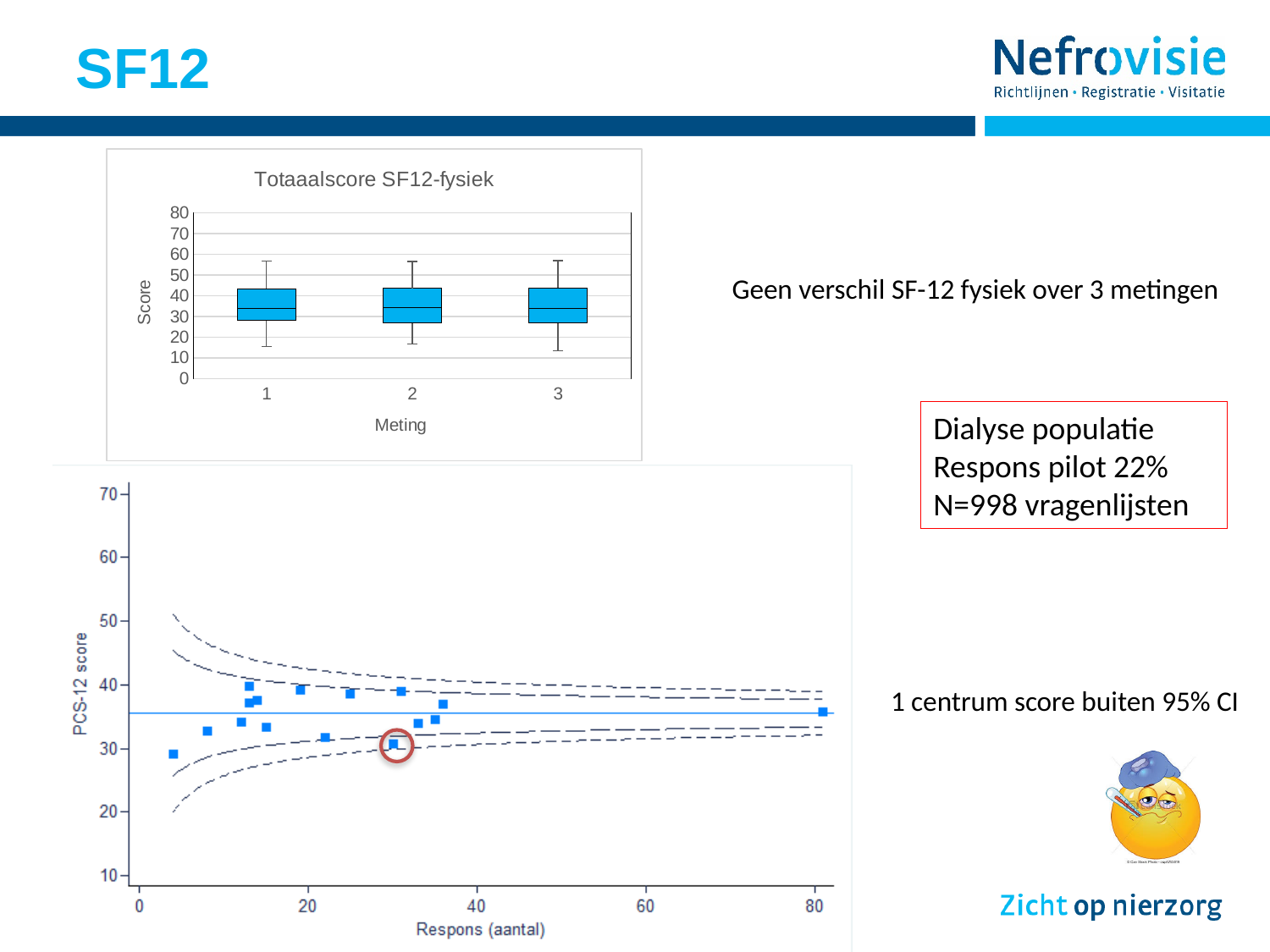
What kind of chart is the lower-left chart with 'PCS-12 score' on the y axis? scatter plot In the lower-left chart, how many points are circled in red? 1 In the lower-left chart, what is the label of the x axis? Respons (aantal) In the chart titled 'Totaaalscore SF12-fysiek', what is the highest value shown on the y axis? 80 In the chart titled 'Totaaalscore SF12-fysiek', is the top of the upper whisker for Meting 3 greater or less than 50? greater What kind of chart is the chart titled 'Totaaalscore SF12-fysiek'? box plot In the chart titled 'Totaaalscore SF12-fysiek', what is the label of the x axis? Meting In the chart titled 'Totaaalscore SF12-fysiek', is the median score for Meting 1 greater or less than 50? less In the chart titled 'Totaaalscore SF12-fysiek', how many boxes (Meting categories) are plotted? 3 In the lower-left chart, is the PCS-12 score of the point with the largest Respons (around 80) greater or less than 30? greater